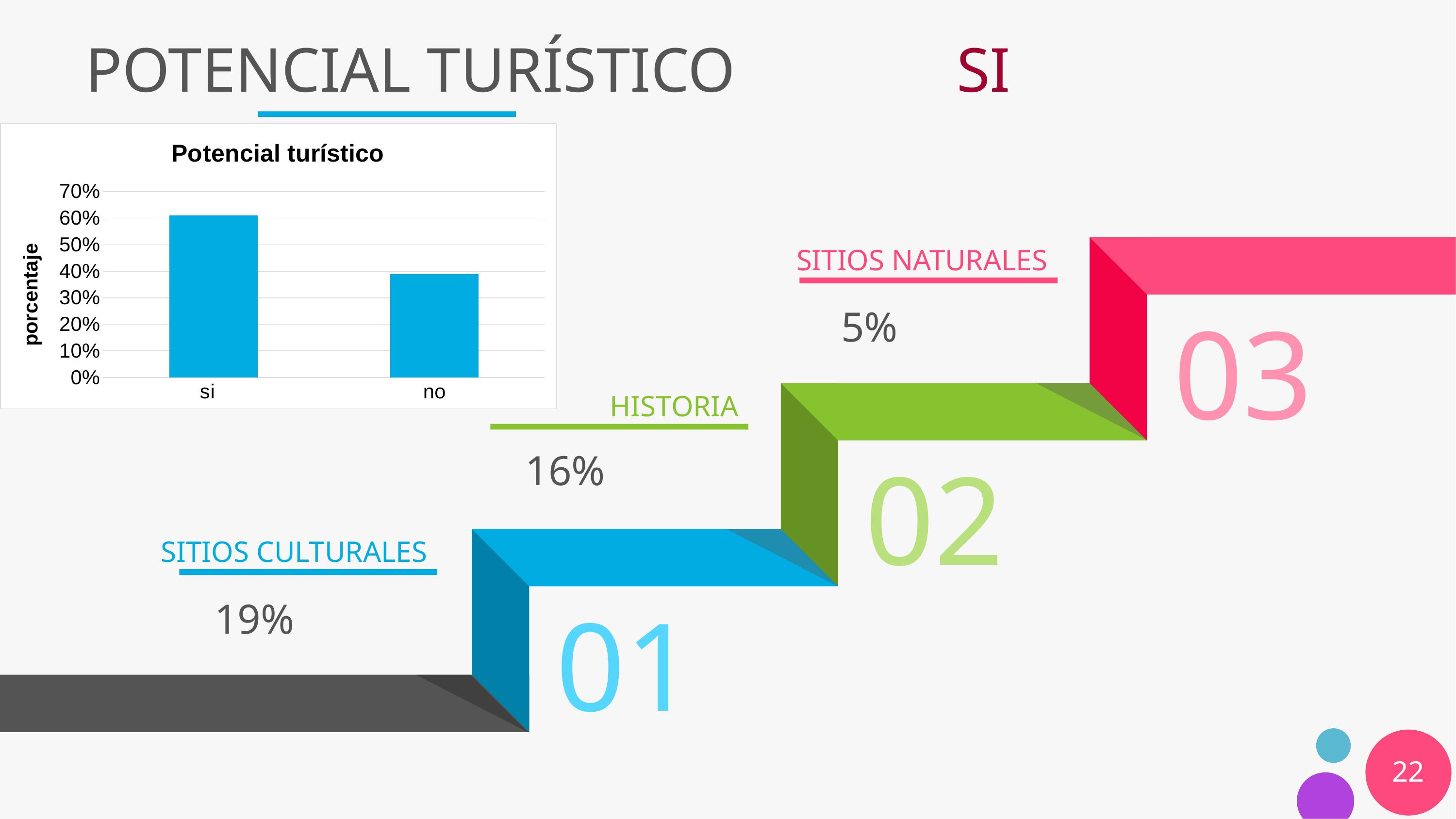
What is the title of the chart? Potencial turístico Is the value for no greater or less than 50%? less Which category has the highest value in the chart? si Is the value for no greater or less than 30%? greater Which category has the lowest value in the chart? no What is the label on the vertical axis of the chart? porcentaje Is the value for si greater or less than 70%? less What type of chart is shown on the slide? bar chart Which is larger, the value for si or the value for no? si Do the values rise or fall from si to no along the x axis? fall How many categories are plotted in the chart? 2